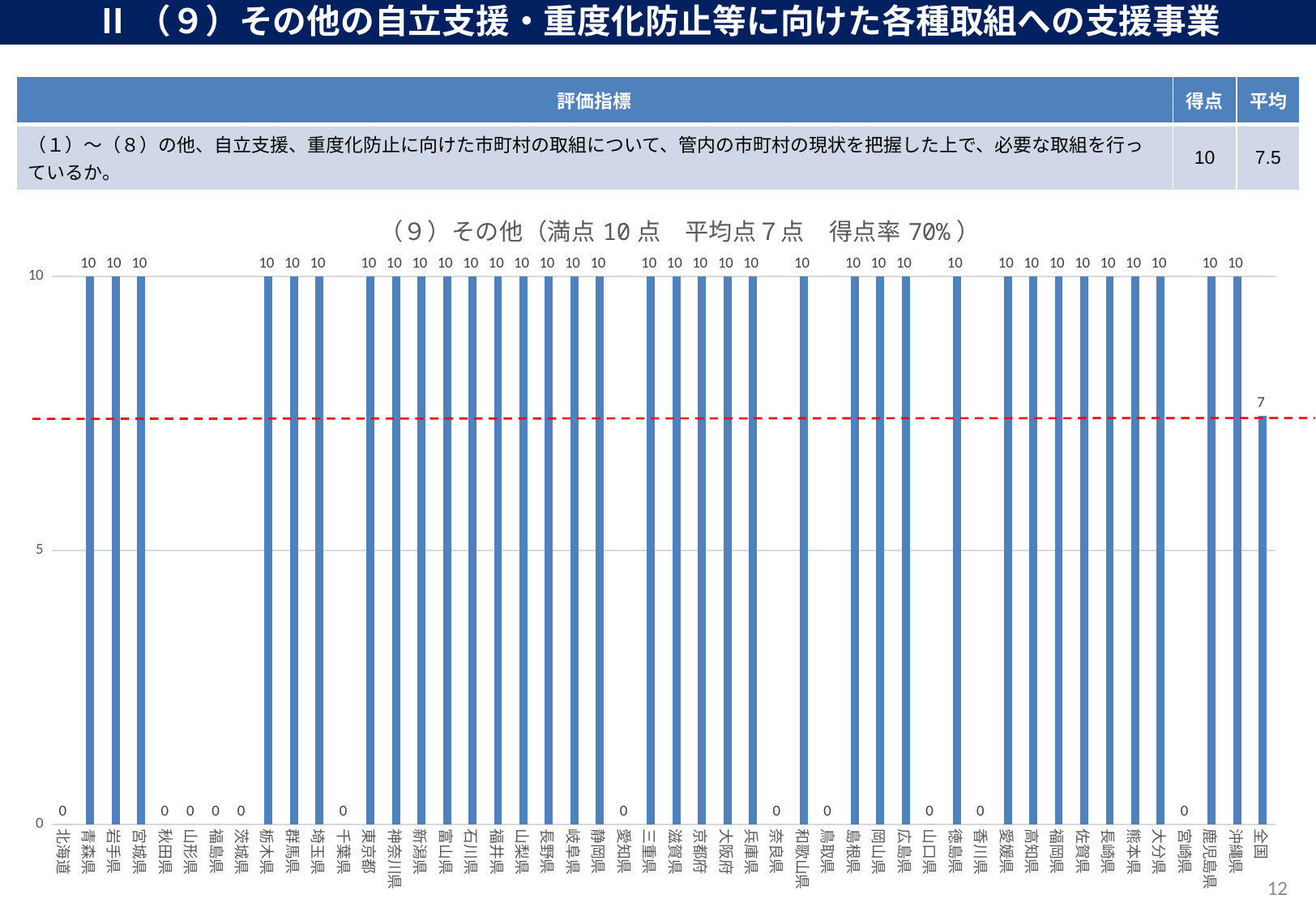
What is the value for 愛知県 in the chart? 0 How many categories in the chart have a value of 0? 12 How many categories are shown on the x axis of the chart? 48 Which is larger, the value for 東京都 or the value for 千葉県? 東京都 What kind of chart is shown on the slide? bar chart What is the title of the chart? （９）その他（満点 10 点 平均点７点 得点率 70%） What is the value for 全国 in the chart? 7 What is the difference between the value for 鹿児島県 and the value for 全国? 3 What is the value for 北海道 in the chart? 0 What is the value for 沖縄県 in the chart? 10 Is the value for 全国 greater or less than 5? greater What is the value for 青森県 in the chart? 10